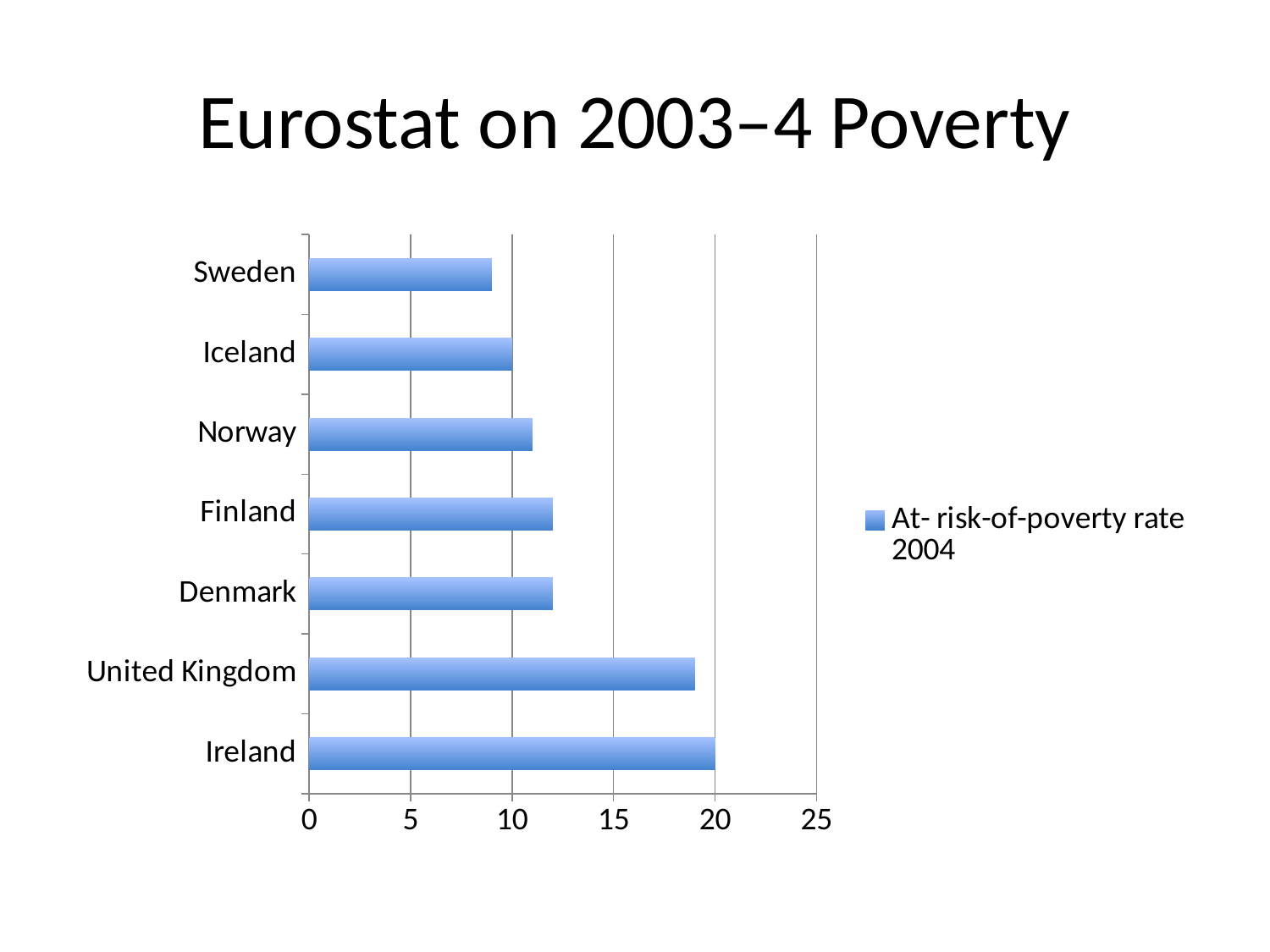
Which country has the highest at-risk-of-poverty rate on the chart? Ireland How many series does the legend list? 1 What is the at-risk-of-poverty rate for Iceland? 10 Which has a higher at-risk-of-poverty rate, United Kingdom or Denmark? United Kingdom Is the value for Sweden greater or less than 10? less Which country has the lowest at-risk-of-poverty rate on the chart? Sweden How many countries are shown on the chart? 7 What is the at-risk-of-poverty rate for Ireland? 20 Is the value for Norway greater or less than 10? greater What series name is shown in the legend? At- risk-of-poverty rate 2004 Is the value for United Kingdom greater or less than 15? greater What kind of chart is shown on the slide? bar chart